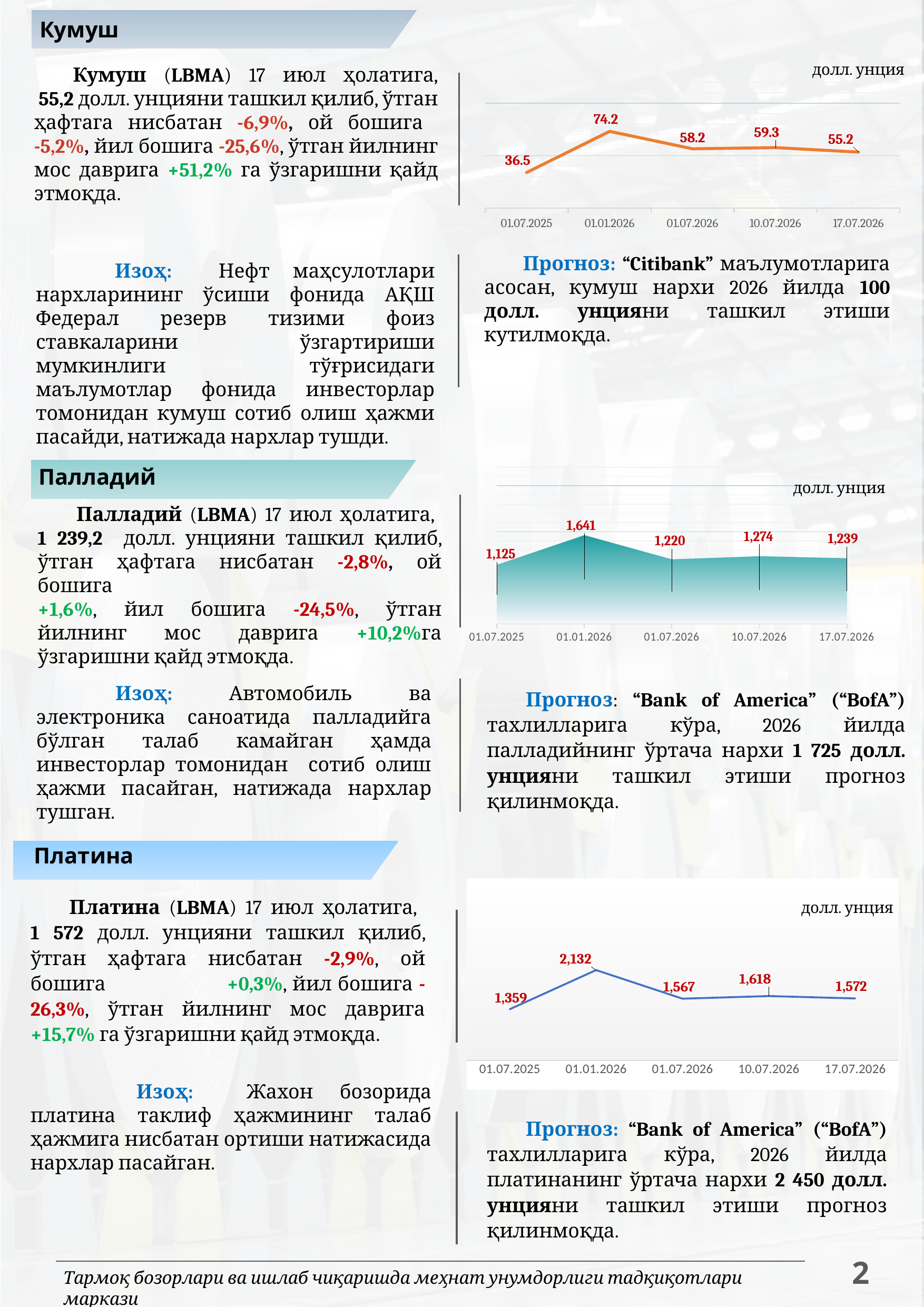
On the bottom chart (platinum, Платина section), what is the difference between the values for 01.01.2026 and 17.07.2026? 560 On the top chart (silver, Кумуш section), what is the value for 17.07.2026? 55.2 On the top chart (silver, Кумуш section), what is the difference between the values for 01.01.2026 and 01.07.2025? 37.7 On the top chart (silver, Кумуш section), how many data points are plotted? 5 On the top chart (silver, Кумуш section), which date has the highest value? 01.01.2026 On the top chart (silver, Кумуш section), which date has the lowest value? 01.07.2025 On the middle chart (palladium, Палладий section), what is the difference between the values for 10.07.2026 and 17.07.2026? 35 What type of chart is the bottom chart (platinum, Платина section)? line chart On the middle chart (palladium, Палладий section), which is larger: the value for 10.07.2026 or 17.07.2026? 10.07.2026 On the bottom chart (platinum, Платина section), which date has the highest value? 01.01.2026 On the bottom chart (platinum, Платина section), what is the value for 01.07.2025? 1,359 On the middle chart (palladium, Палладий section), what is the value for 01.01.2026? 1,641